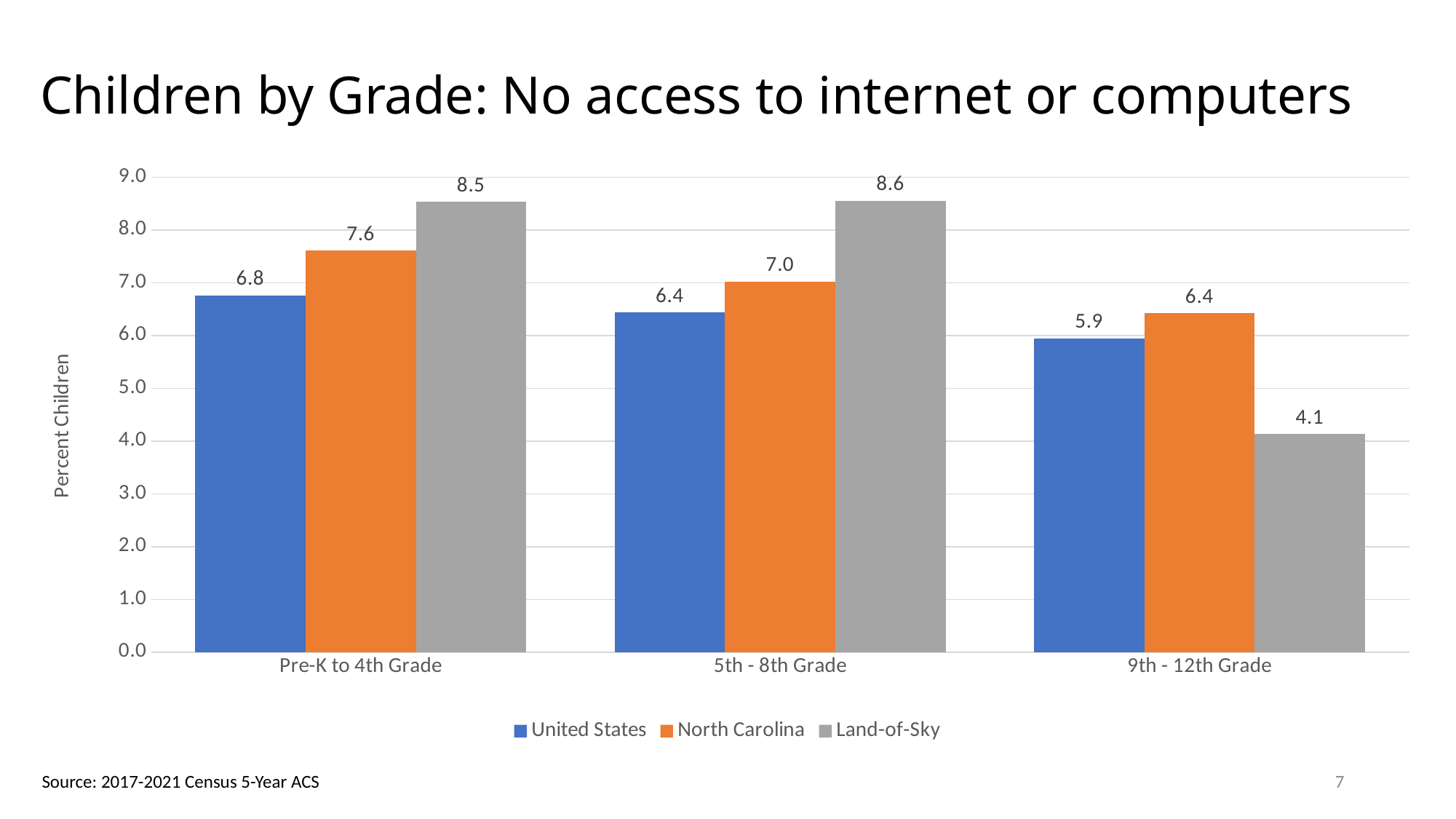
What is the difference between the Land-of-Sky value and the United States value in the 5th - 8th Grade category? 2.2 What is the value for United States in the 9th - 12th Grade category? 5.9 Which series has the highest value in the Pre-K to 4th Grade category? Land-of-Sky Which is larger: the North Carolina value for 9th - 12th Grade or the Land-of-Sky value for 9th - 12th Grade? North Carolina How many grade categories are shown on the x axis? 3 What kind of chart is shown on the slide? Bar chart Do the United States values rise or fall from Pre-K to 4th Grade to 9th - 12th Grade? Fall Which series has the lowest value in the 9th - 12th Grade category? Land-of-Sky Is the Land-of-Sky value for 9th - 12th Grade greater or less than 5.0? less What is the value for North Carolina in the Pre-K to 4th Grade category? 7.6 How many series does the legend list? 3 What is the value for Land-of-Sky in the 5th - 8th Grade category? 8.6